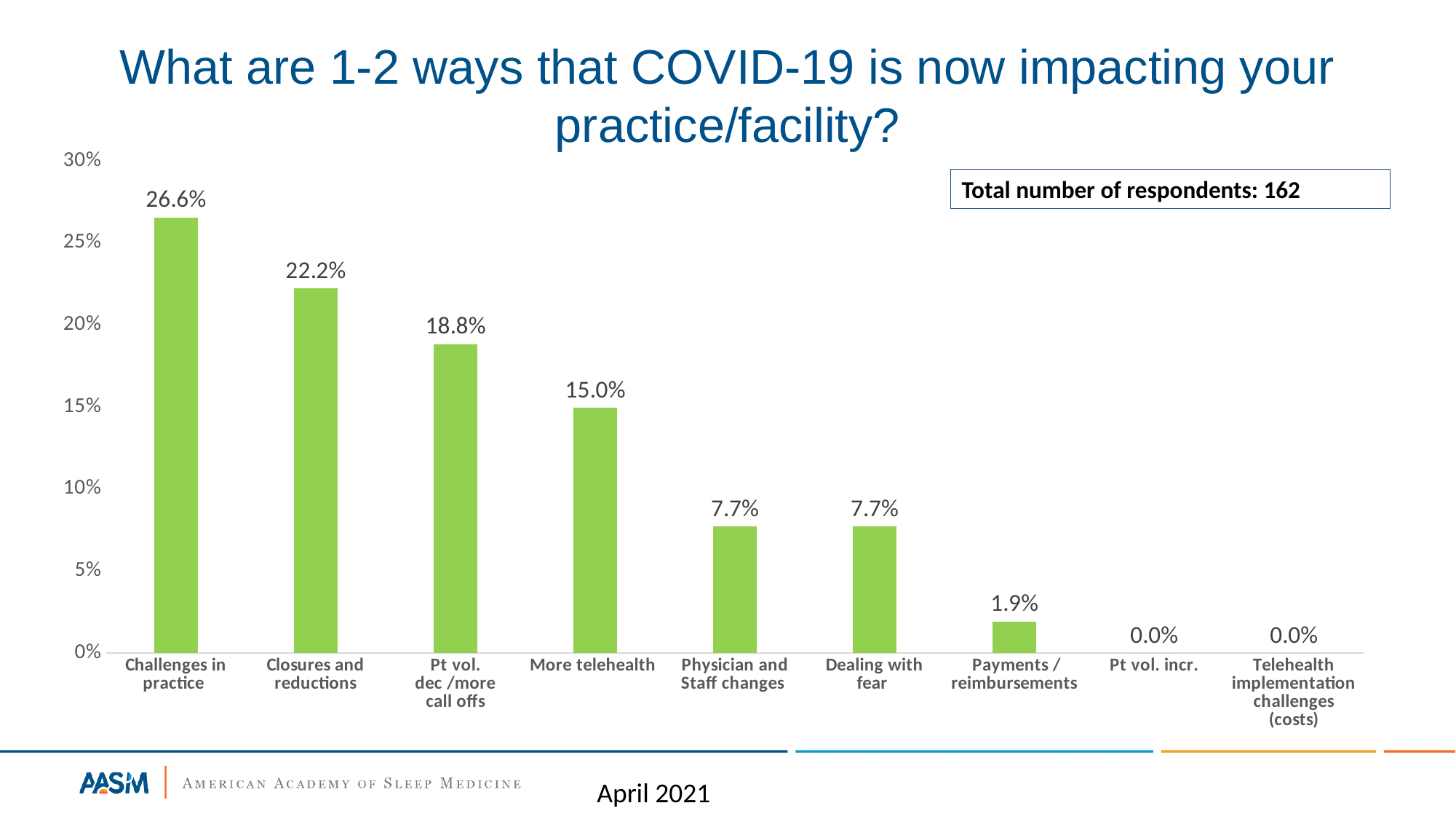
Is the value for Pt vol. dec /more call offs greater or less than 20%? less Do the values rise or fall from left to right along the x axis? fall Which category has the highest value? Challenges in practice What is the difference between Closures and reductions and Pt vol. dec /more call offs? 3.4% What is the value for More telehealth? 15.0% What is the value for Payments / reimbursements? 1.9% What is the total number of respondents stated on the slide? 162 How many categories are shown on the x axis? 9 What is the difference between Challenges in practice and More telehealth? 11.6% What kind of chart is shown on the slide? bar chart Which is larger, Closures and reductions or More telehealth? Closures and reductions What is the value for Challenges in practice? 26.6%